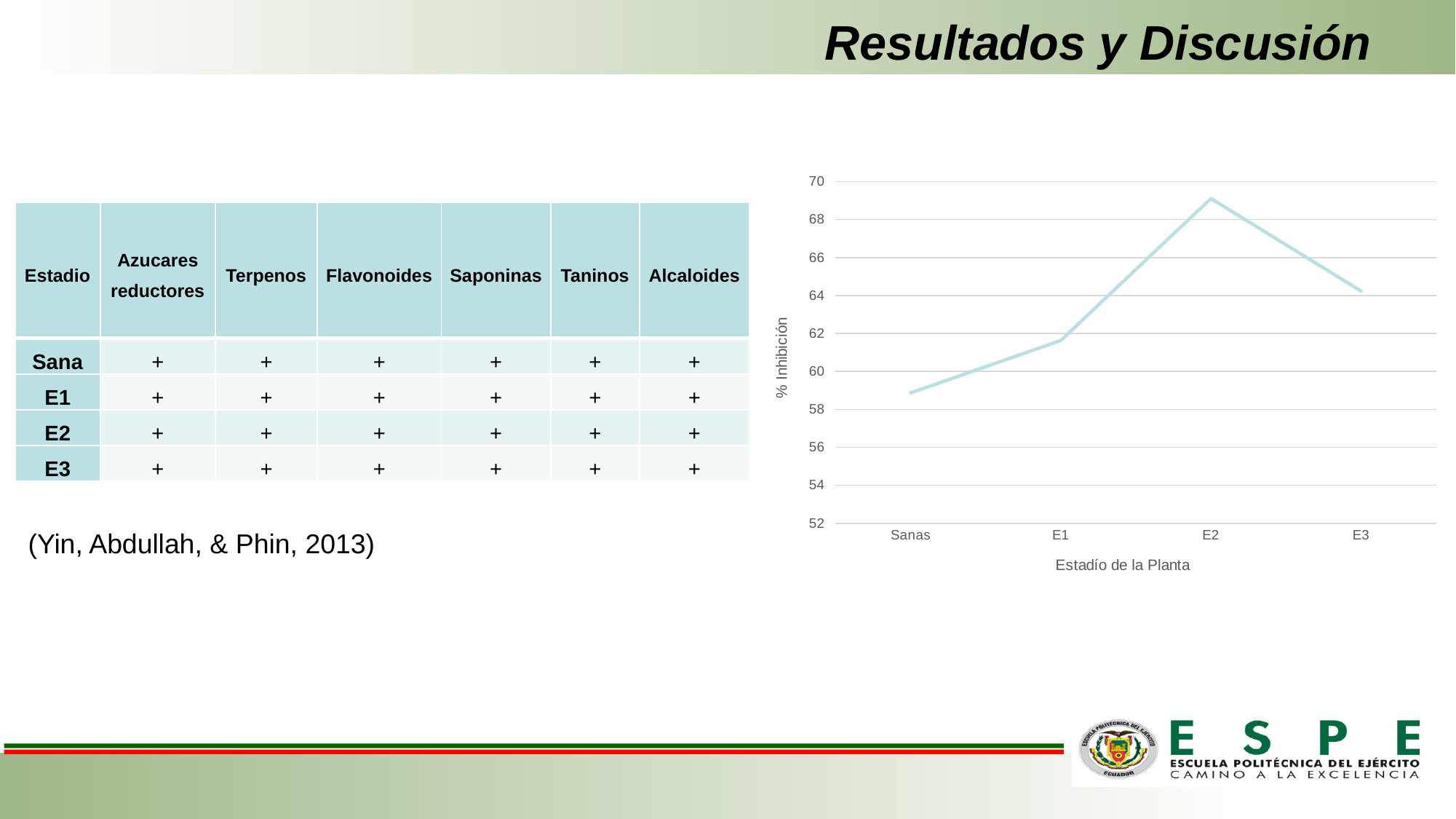
Is the % Inhibición for E2 greater or less than 68? greater What is the label of the y axis of the line chart? % Inhibición Which plant stage has the highest % Inhibición in the line chart? E2 Which plant stage has the lowest % Inhibición in the line chart? Sanas Which has a higher % Inhibición, E1 or E3? E3 What kind of chart is shown on the right side of the slide? line chart Is the % Inhibición for Sanas greater or less than 60? less Does the % Inhibición rise or fall from Sanas to E2? rise How many plant stages are plotted along the x axis of the line chart? 4 What is the label of the x axis of the line chart? Estadío de la Planta